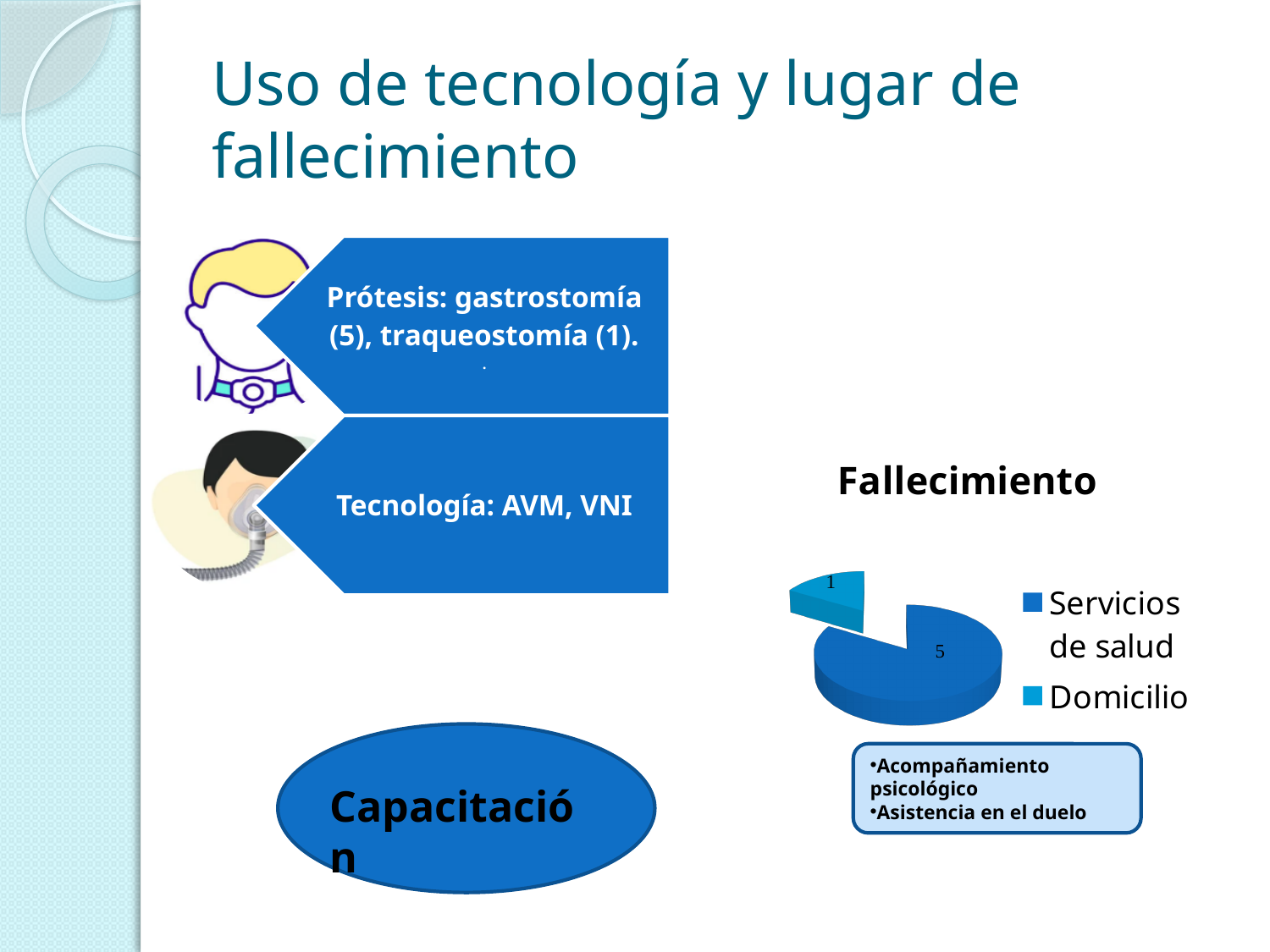
What is the title of the pie chart on the slide? Fallecimiento In the "Fallecimiento" pie chart, what is the difference between the values for "Servicios de salud" and "Domicilio"? 4 What is the value for "Servicios de salud" in the "Fallecimiento" pie chart? 5 How many slices does the "Fallecimiento" pie chart have? 2 How many entries does the legend of the "Fallecimiento" pie chart list? 2 In the "Fallecimiento" pie chart, which is larger: "Servicios de salud" or "Domicilio"? Servicios de salud Which category has the smallest slice in the "Fallecimiento" pie chart? Domicilio What is the value for "Domicilio" in the "Fallecimiento" pie chart? 1 Which category has the largest slice in the "Fallecimiento" pie chart? Servicios de salud What kind of chart is shown under the title "Fallecimiento"? Pie chart What is the total of all slices in the "Fallecimiento" pie chart? 6 What are the legend entries of the "Fallecimiento" pie chart? Servicios de salud, Domicilio